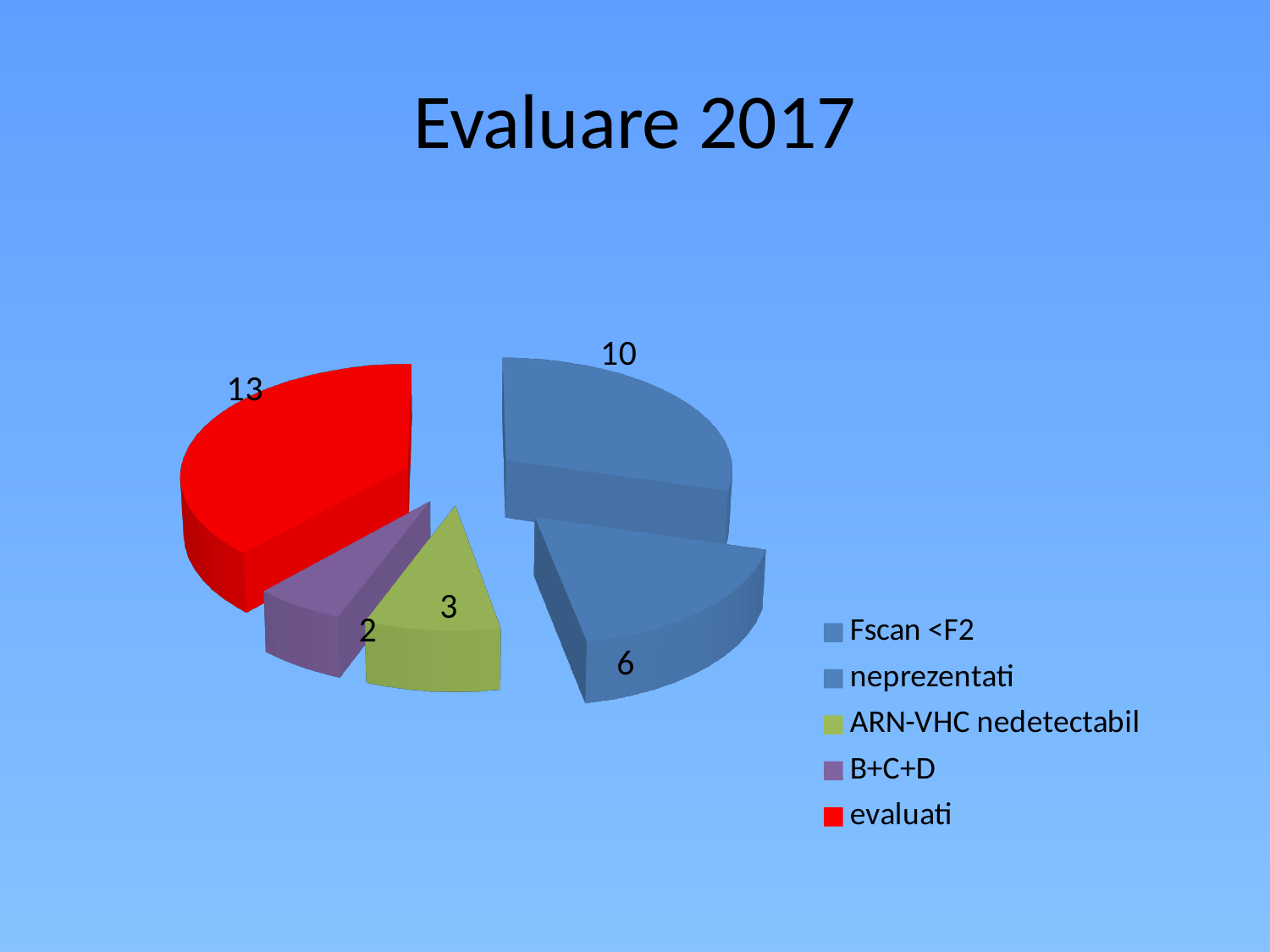
What is the value of the B+C+D slice? 2 What is the title of the chart? Evaluare 2017 Which category has the smallest slice? B+C+D What is the value of the ARN-VHC nedetectabil slice? 3 How many entries does the legend list? 5 Which category has the largest slice? evaluati Which is larger, the Fscan <F2 slice or the neprezentati slice? Fscan <F2 What is the difference between the evaluati value and the neprezentati value? 7 How many slices does the pie chart have? 5 What kind of chart is shown on the slide? pie chart What is the value of the Fscan <F2 slice? 10 What is the value of the evaluati slice? 13